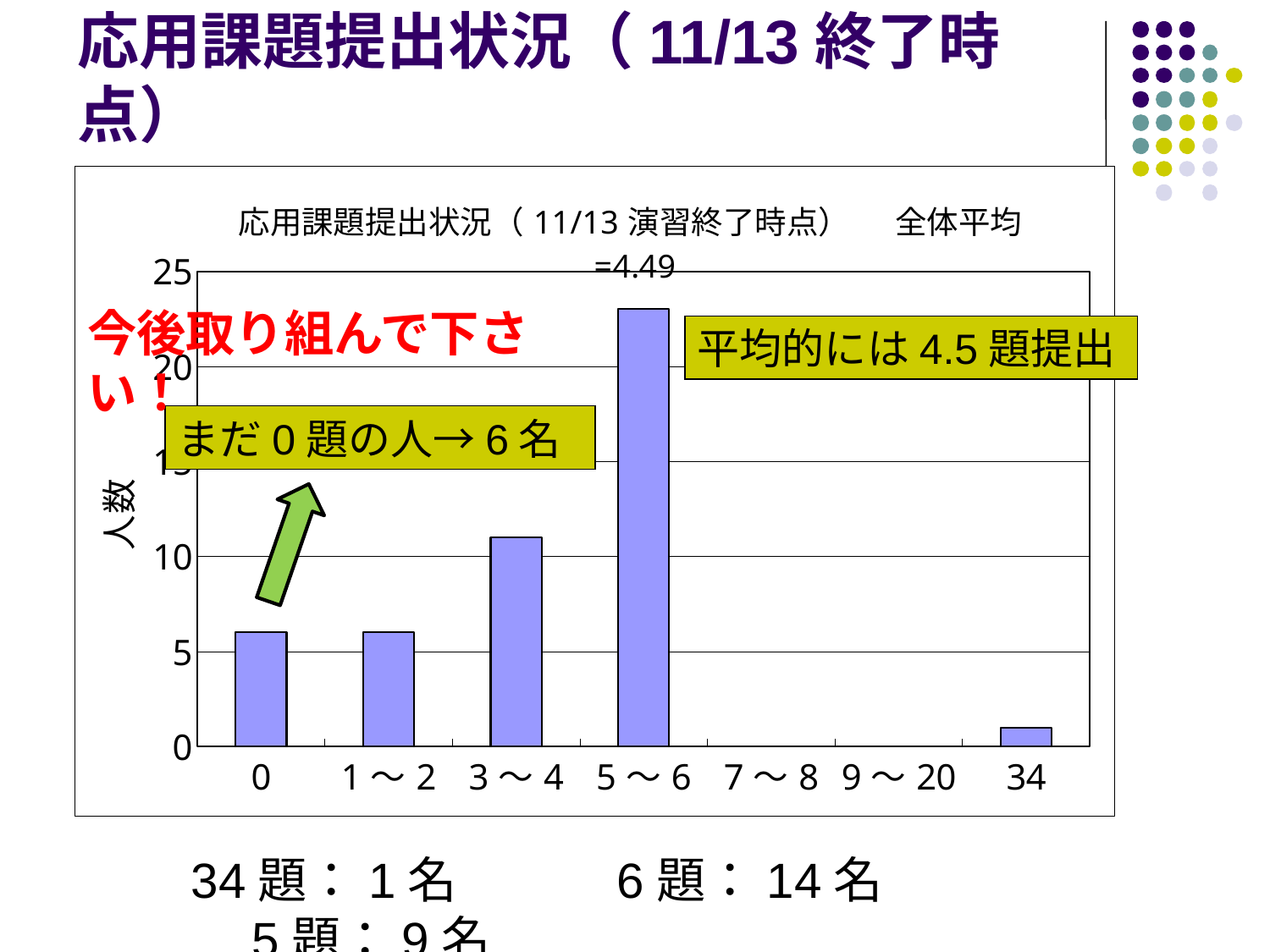
How many categories are shown on the x axis of the chart? 7 Is the value for the 5～6 category greater or less than 20? greater What is the overall average (全体平均) stated in the chart title? 4.49 Which category has a larger value, 0 or 34? 0 Which category has the highest bar in the chart? 5～6 According to the text below the chart, how many people are in the 34 category? 1名 Which category has a larger value, 3～4 or 1～2? 3～4 Is the value for the 1～2 category greater or less than 10? less What is the label of the vertical axis of the chart? 人数 What kind of chart is shown on the slide? bar chart Is the value for the 3～4 category greater or less than 10? greater According to the annotation on the chart, how many people have submitted 0 problems (category 0)? 6名